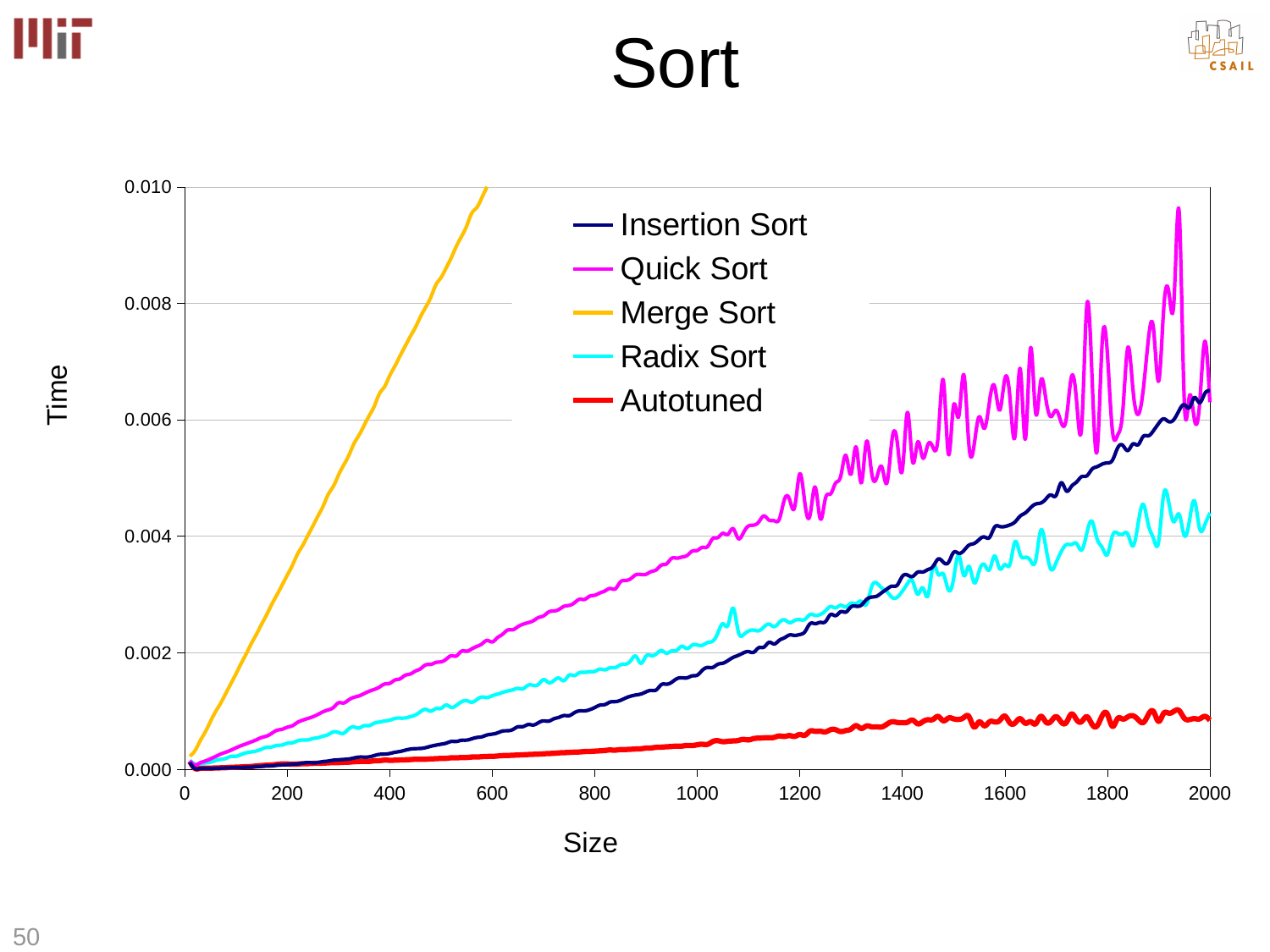
Is the value for Merge Sort at size 400 greater or less than 0.004? greater Does the Insertion Sort line rise or fall as size increases? rise At size 1000, which is larger: Quick Sort or Insertion Sort? Quick Sort Is the value for Quick Sort at size 1000 greater or less than 0.002? greater Which series has the lowest time across the whole range of sizes? Autotuned What kind of chart is shown on the slide? line chart How many series does the legend list? 5 Is the value for Radix Sort at size 1000 greater or less than 0.004? less What is the label of the y axis? Time What is the label of the x axis? Size Which series reaches the top of the chart (0.010) at the smallest size? Merge Sort